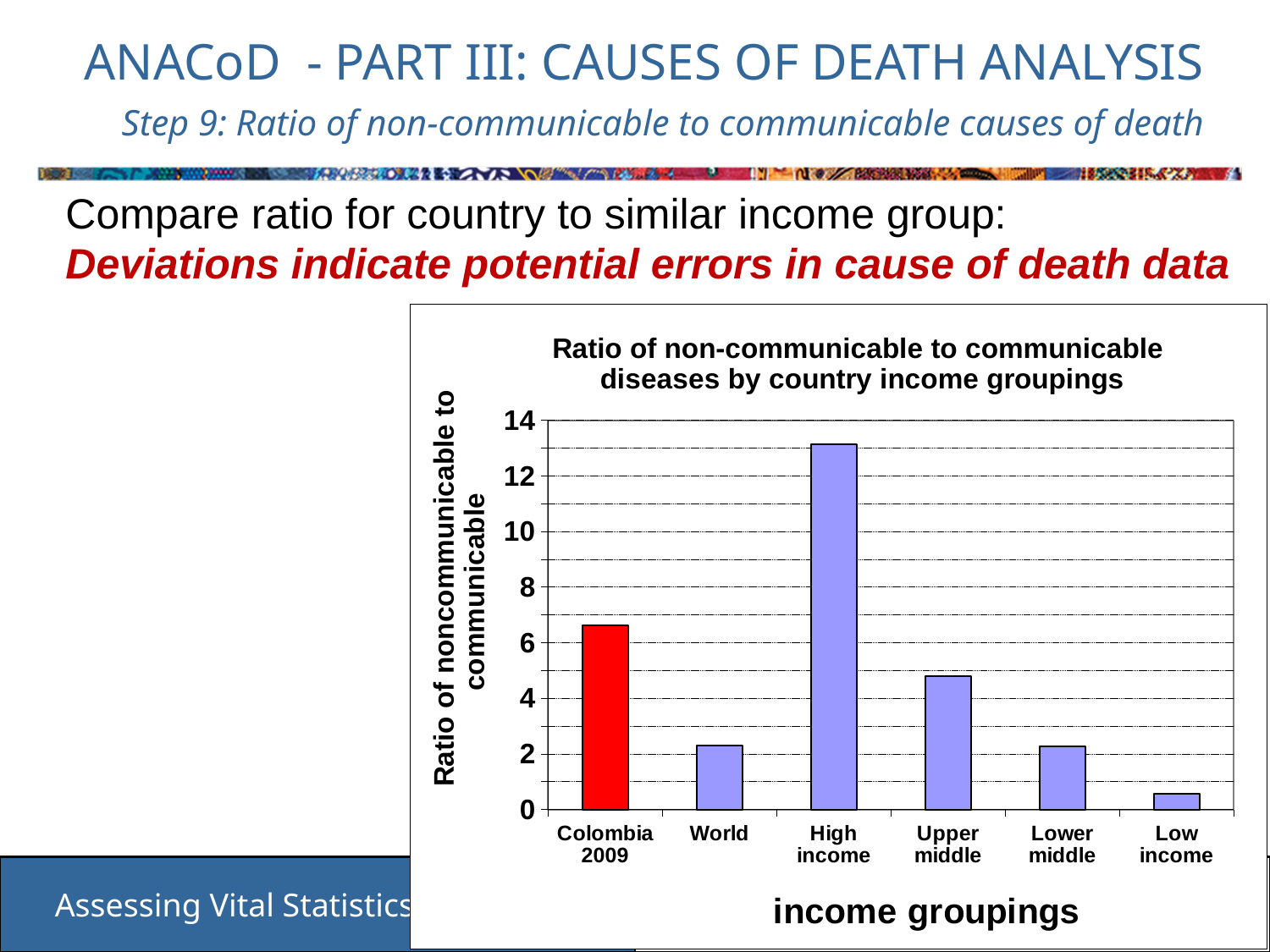
Is the value for Low income greater or less than 2? less Which bar in the chart is coloured red? Colombia 2009 How many categories are shown on the x axis of the chart? 6 Is the value for High income greater or less than 12? greater Is the value for World greater or less than 4? less What kind of chart is shown on the slide? bar chart Which has a larger ratio, Colombia 2009 or Upper middle? Colombia 2009 Which category has the lowest ratio of non-communicable to communicable diseases? Low income Which income grouping has the highest ratio of non-communicable to communicable diseases? High income What is the title of the chart? Ratio of non-communicable to communicable diseases by country income groupings